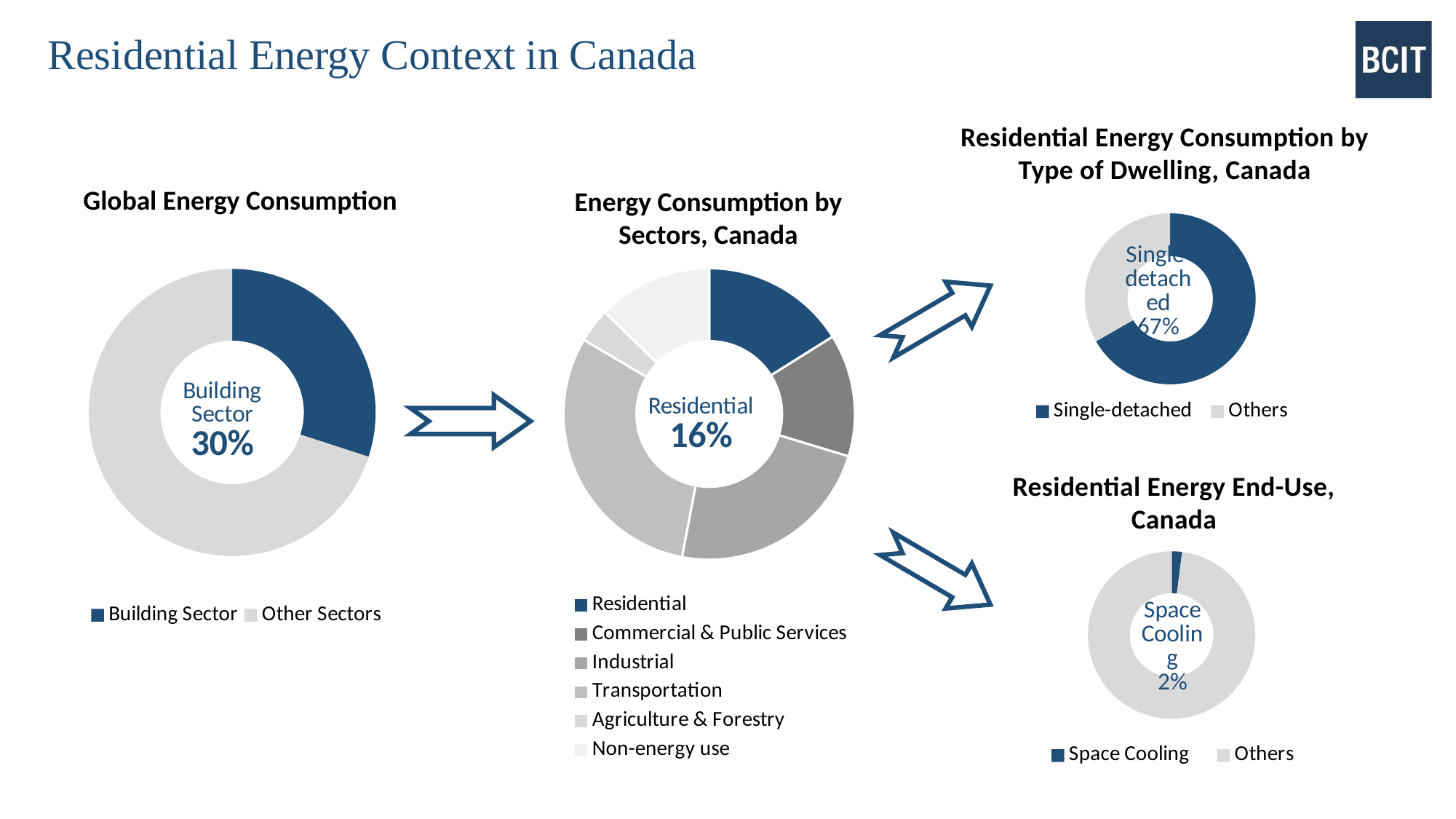
In the Residential Energy Consumption by Type of Dwelling, Canada chart, what share is Single-detached? 67% How many charts are shown on the slide? 4 In the Global Energy Consumption chart, which is larger, Building Sector or Other Sectors? Other Sectors In the Global Energy Consumption chart, what share is the Building Sector? 30% In the Residential Energy Consumption by Type of Dwelling, Canada chart, which is larger, Single-detached or Others? Single-detached In the Energy Consumption by Sectors, Canada chart, what share is Residential? 16% What kind of chart is the Global Energy Consumption chart? Donut (pie) chart How many categories does the legend of the Energy Consumption by Sectors, Canada chart list? 6 How many categories does the legend of the Residential Energy End-Use, Canada chart list? 2 In the Residential Energy End-Use, Canada chart, what share is Space Cooling? 2% In the Energy Consumption by Sectors, Canada chart, which sector has the smallest slice? Agriculture & Forestry In the Residential Energy End-Use, Canada chart, which is larger, Space Cooling or Others? Others